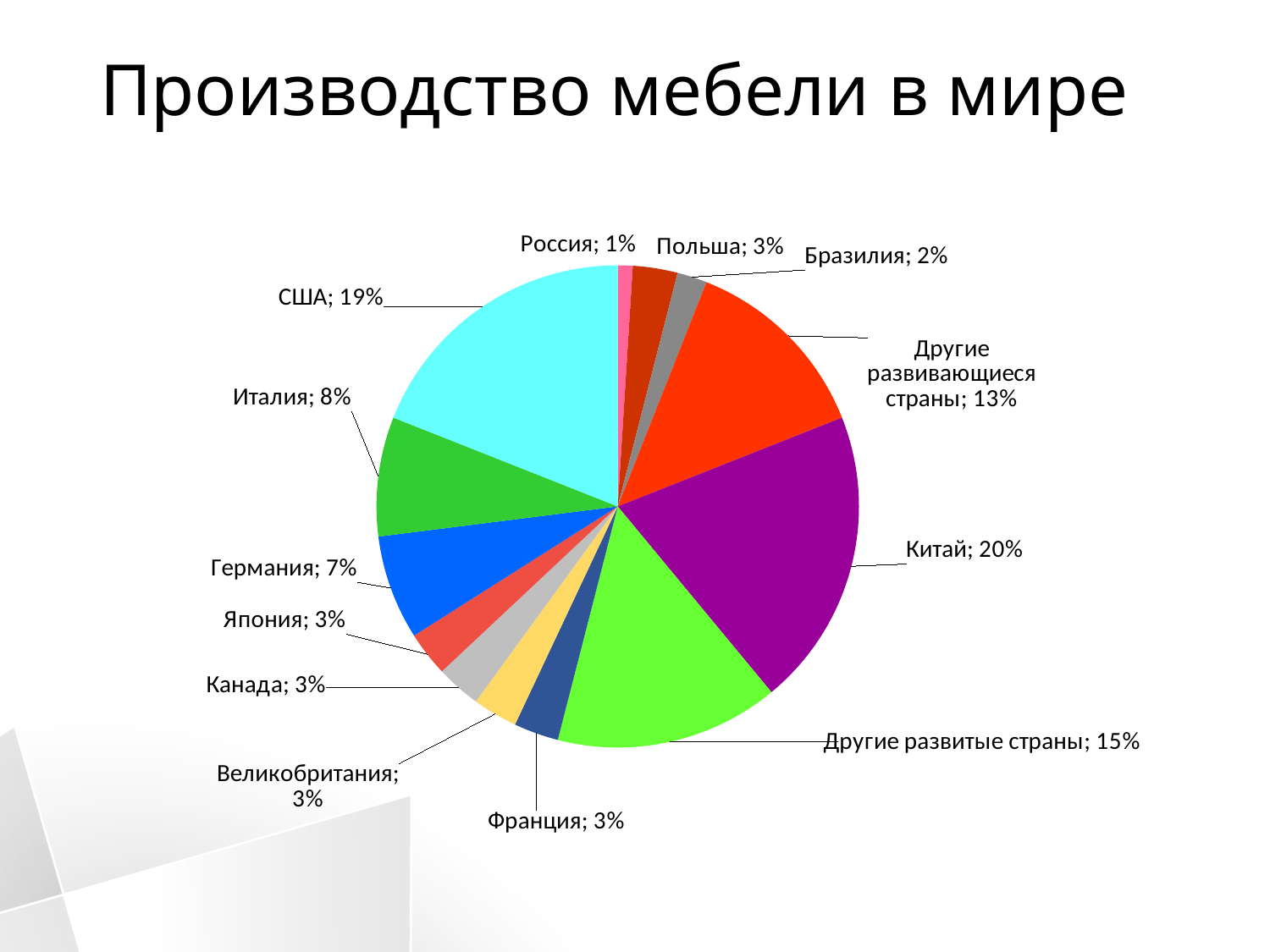
What is the title of the chart? Производство мебели в мире How many slices does the pie chart have? 13 What share of the pie does Китай have? 20% What is the combined share of США and Китай? 39% What kind of chart is shown on the slide? pie chart Which category has the largest slice of the pie? Китай What is the difference between the shares of Китай and Италия? 12% Which category has the smallest slice of the pie? Россия Which is larger, the share of Другие развитые страны or the share of Другие развивающиеся страны? Другие развитые страны What share of the pie does США have? 19% What is the value for Германия? 7% What is the value for Другие развивающиеся страны? 13%